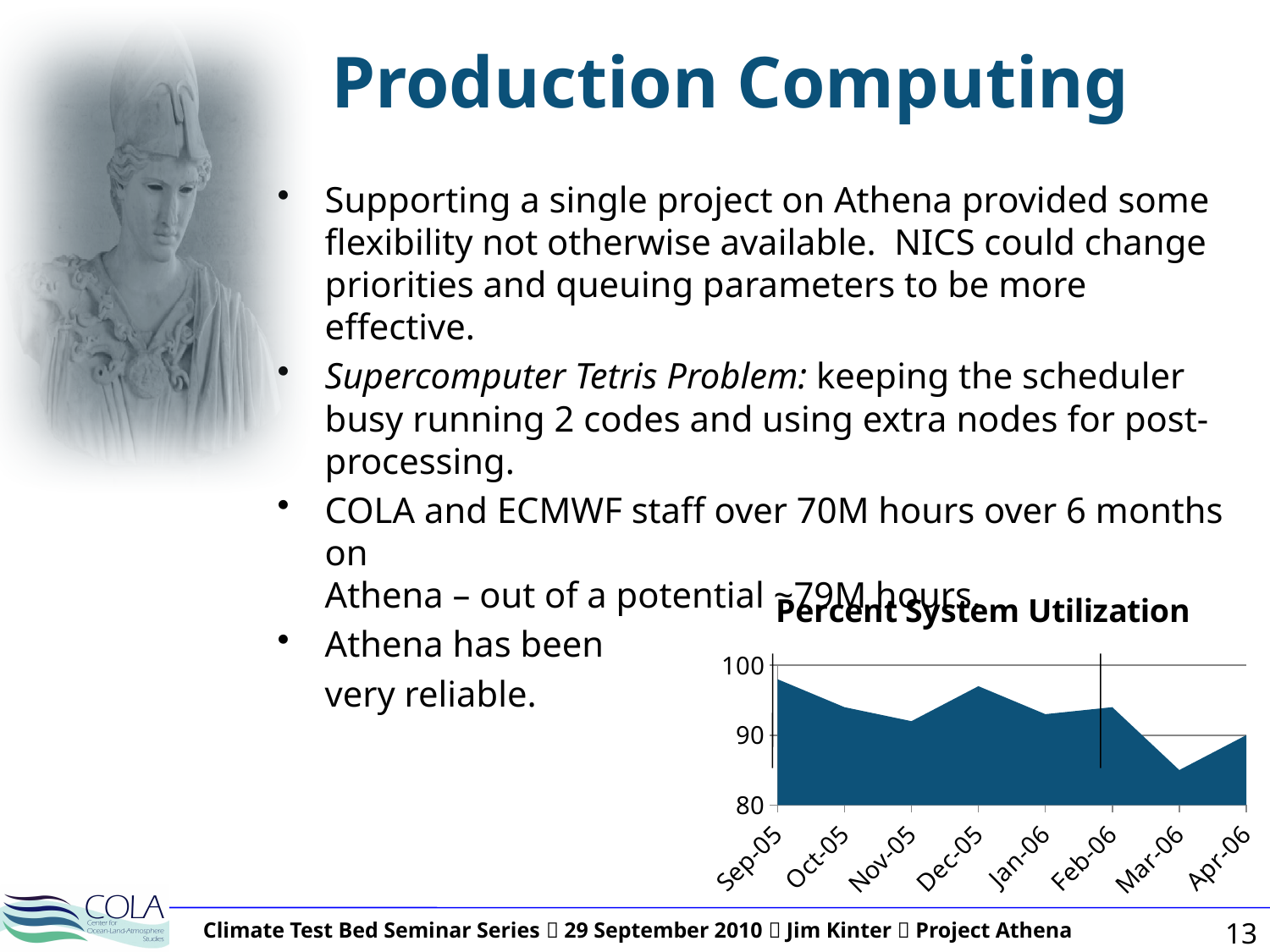
Does the percent system utilization rise or fall from Sep-05 to Nov-05? Fall Which is larger, the value for Oct-05 or the value for Mar-06? Oct-05 Which month has the lowest percent system utilization? Mar-06 Is the value for Mar-06 greater or less than 90? less What kind of chart is shown on the slide? Area chart Which month has the highest percent system utilization? Sep-05 Is the value for Sep-05 greater or less than 90? greater What is the title of the chart? Percent System Utilization How many months are plotted along the x axis of the chart? 8 Is the value for Sep-05 greater or less than 100? less Which is larger, the value for Dec-05 or the value for Nov-05? Dec-05